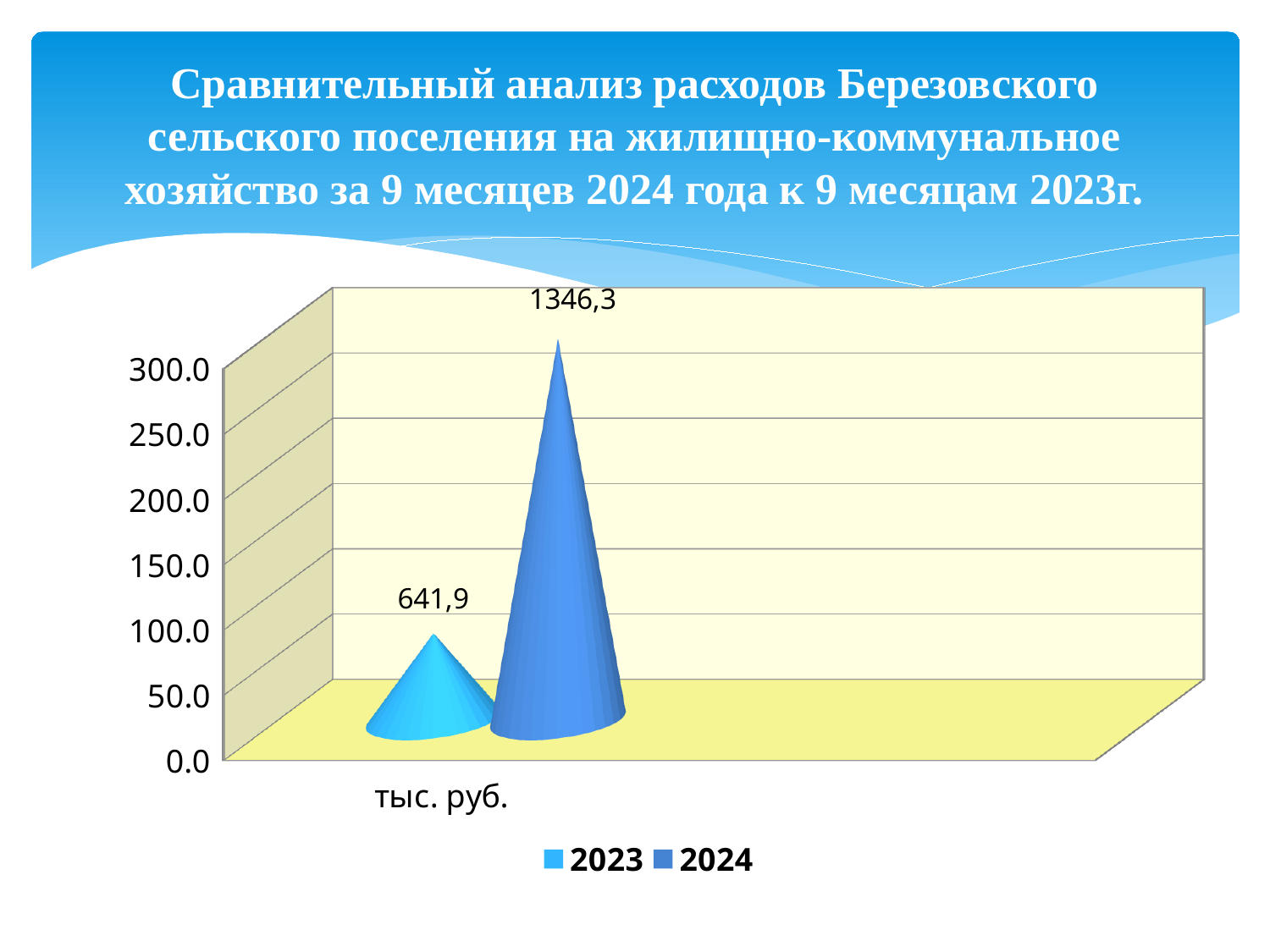
Which series shows the lowest value on the chart? 2023 What is the category label shown on the x axis? тыс. руб. Which series shows the highest value on the chart? 2024 What is the difference between the 2024 value and the 2023 value? 704,4 Which series is shown in the lighter blue colour in the legend? 2023 What kind of chart is shown on the slide? bar chart How many categories are shown on the x axis? 1 Which series has the higher value, 2023 or 2024? 2024 What is the value for 2023 on the chart? 641,9 What is the value for 2024 on the chart? 1346,3 How many series does the legend list? 2